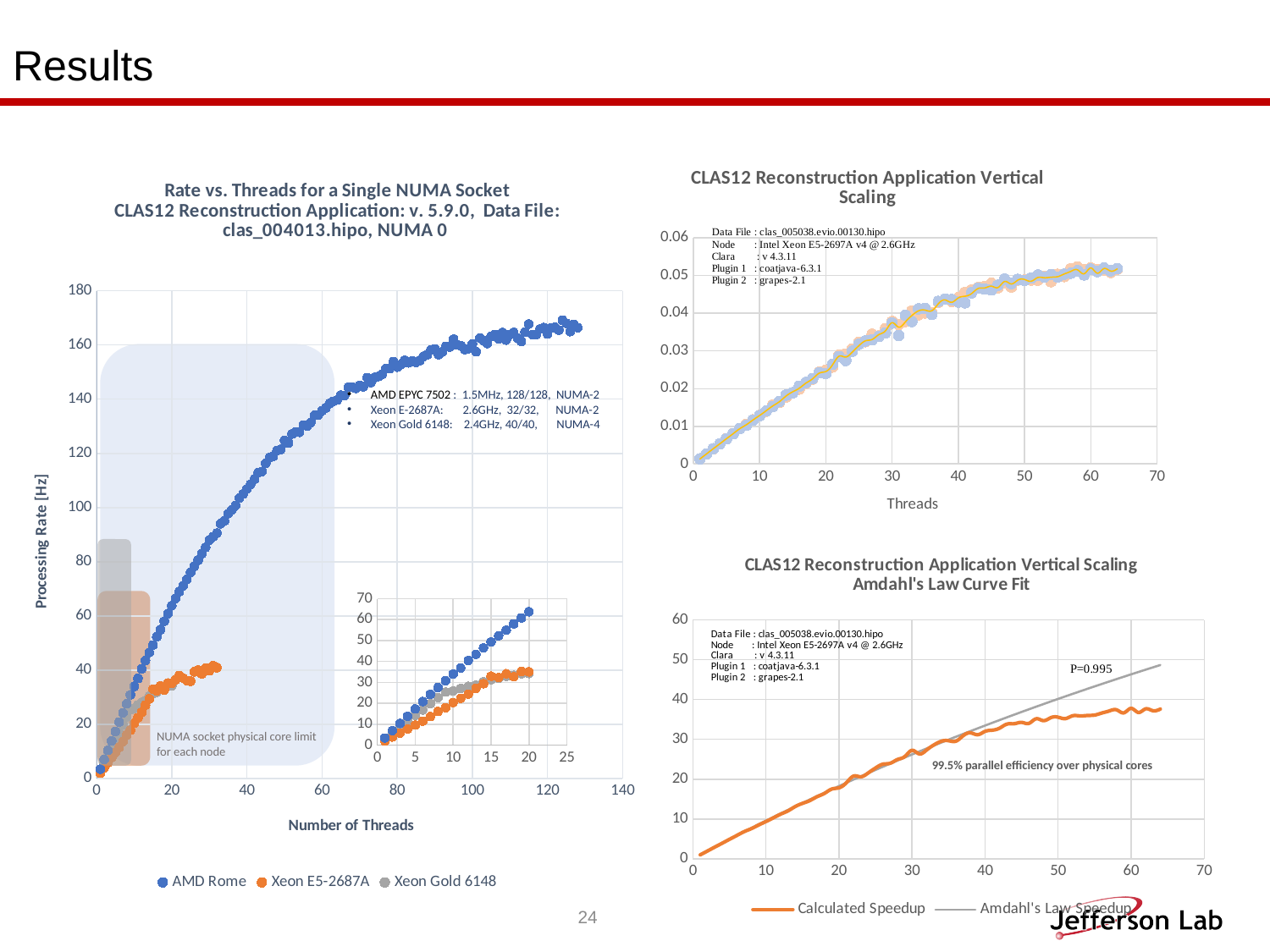
What kind of chart is the top-right chart, 'CLAS12 Reconstruction Application Vertical Scaling'? scatter chart In the bottom-right chart, 'Amdahl's Law Curve Fit', is the Calculated Speedup at 60 threads greater or less than 40? less In the left chart, 'Rate vs. Threads for a Single NUMA Socket', is the Xeon E5-2687A processing rate at 30 threads greater or less than 60? less How many series does the legend of the bottom-right chart, 'Amdahl's Law Curve Fit', list? 2 In the top-right chart, 'CLAS12 Reconstruction Application Vertical Scaling', is the value at 60 threads greater or less than 0.04? greater In the left chart, 'Rate vs. Threads for a Single NUMA Socket', which series reaches the highest processing rate? AMD Rome How many series does the legend of the left chart, 'Rate vs. Threads for a Single NUMA Socket', list? 3 In the left chart, 'Rate vs. Threads for a Single NUMA Socket', does the AMD Rome processing rate rise or fall as the number of threads increases? rise In the bottom-right chart, 'Amdahl's Law Curve Fit', which series is larger at 60 threads, Calculated Speedup or Amdahl's Law Speedup? Amdahl's Law Speedup What is the y-axis title of the left chart, 'Rate vs. Threads for a Single NUMA Socket'? Processing Rate [Hz]